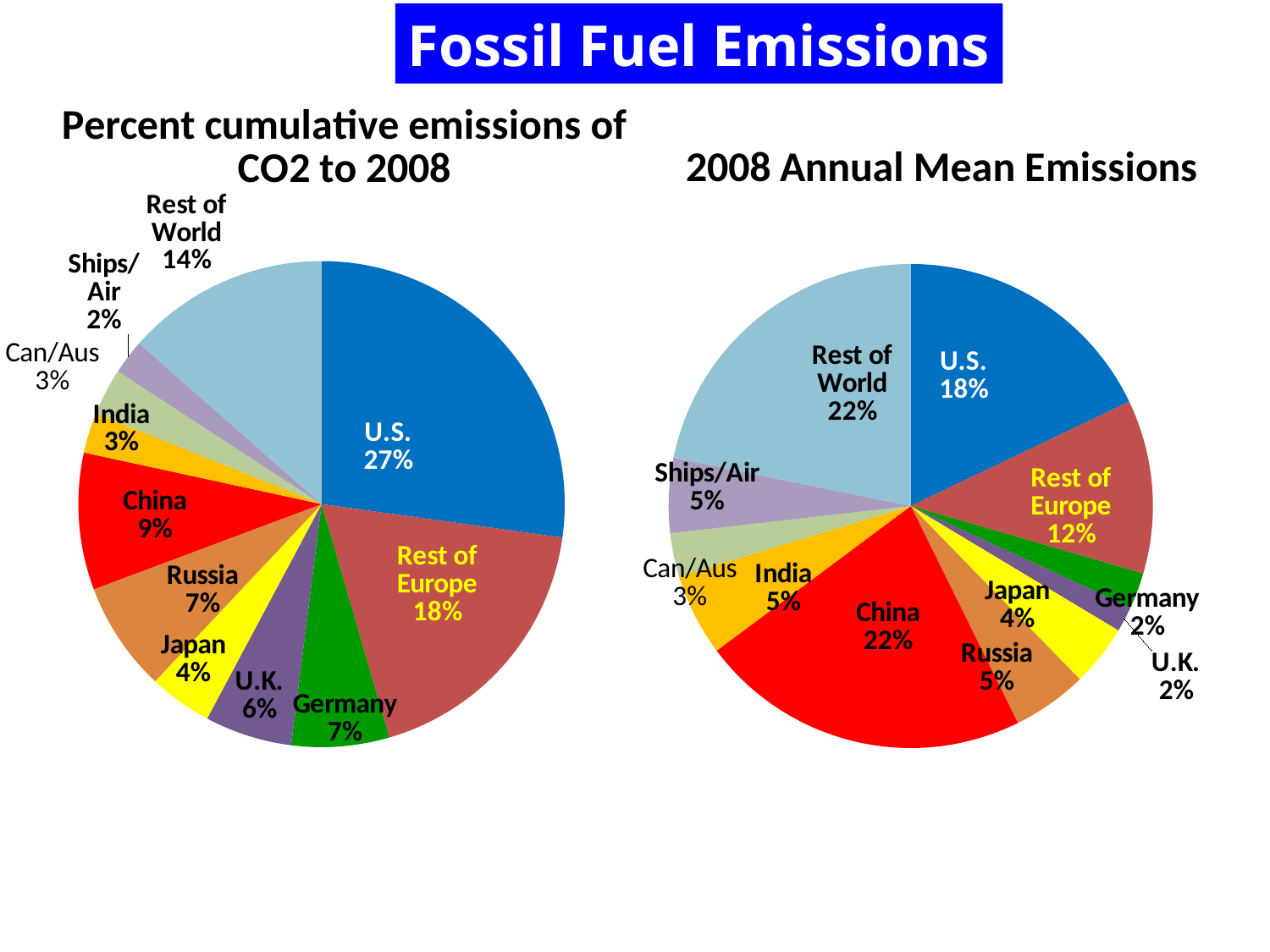
What is the title shown at the top of the slide? Fossil Fuel Emissions In the 'Percent cumulative emissions of CO2 to 2008' chart, which category has the largest slice? U.S. How many slices does the '2008 Annual Mean Emissions' chart have? 11 In the 'Percent cumulative emissions of CO2 to 2008' chart, which category has the smallest slice? Ships/Air In the 'Percent cumulative emissions of CO2 to 2008' chart, what share does the U.S. have? 27% In the '2008 Annual Mean Emissions' chart, what is the difference between the U.S. share and the Rest of Europe share? 6% In the '2008 Annual Mean Emissions' chart, which is larger, Russia or Japan? Russia In the 'Percent cumulative emissions of CO2 to 2008' chart, which is larger, China or Russia? China In the '2008 Annual Mean Emissions' chart, what share does Ships/Air have? 5% In the '2008 Annual Mean Emissions' chart, what share does China have? 22% In the 'Percent cumulative emissions of CO2 to 2008' chart, what share does Germany have? 7% What type of chart is used for 'Percent cumulative emissions of CO2 to 2008'? Pie chart